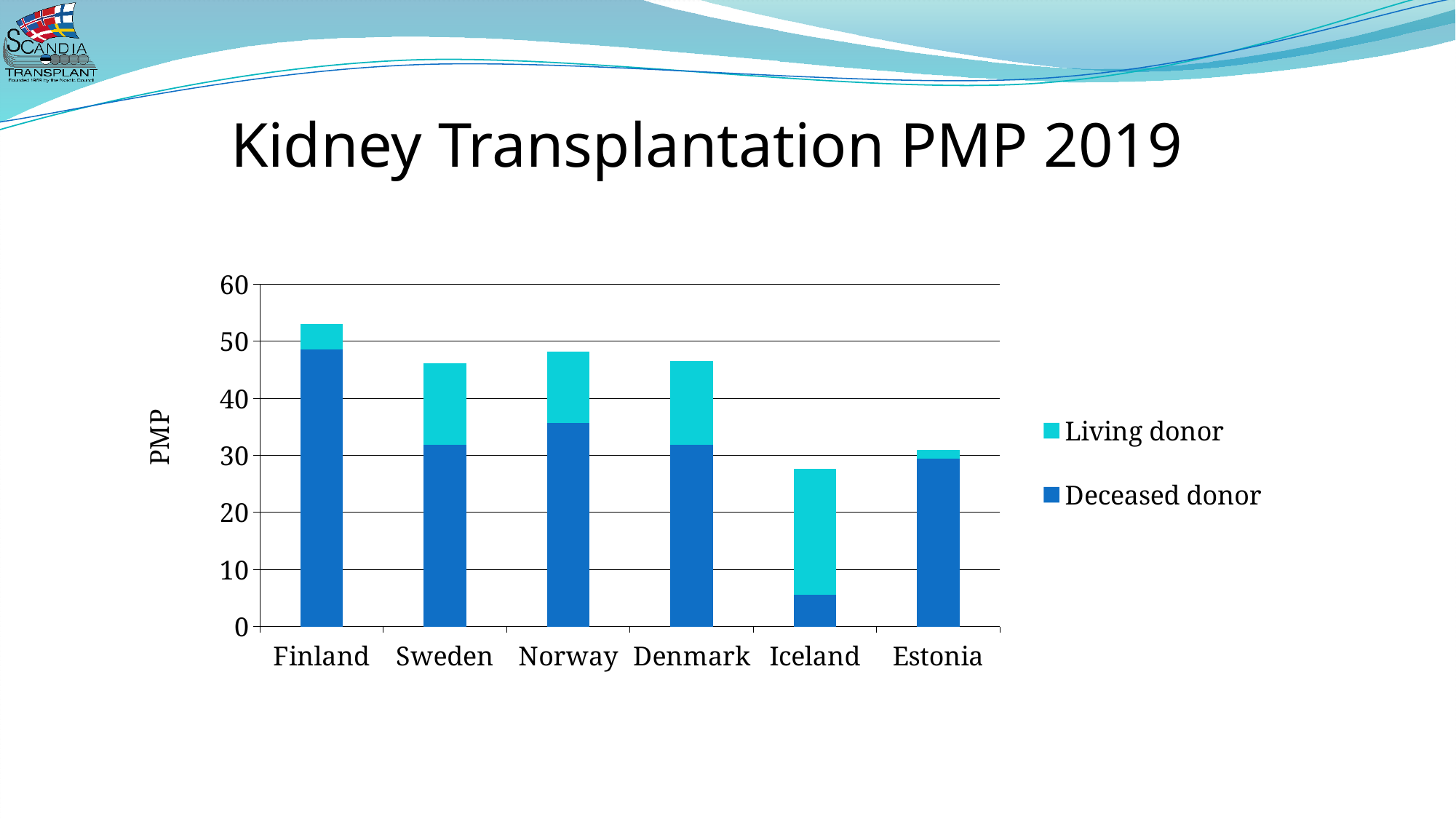
Is the total value for Finland greater or less than 50? greater How many series does the chart legend list? 2 Is the Deceased donor value for Iceland greater or less than 10? less Which country has the lowest total kidney transplantation PMP? Iceland Is the total value for Iceland greater or less than 30? less Which has a larger Deceased donor value, Norway or Sweden? Norway Which country has the highest total kidney transplantation PMP? Finland Which country has the largest Living donor segment? Iceland How many countries are shown on the x axis of the chart? 6 Which country has the smallest Deceased donor segment? Iceland What kind of chart is shown on the slide? stacked bar chart What is the label on the y axis of the chart? PMP